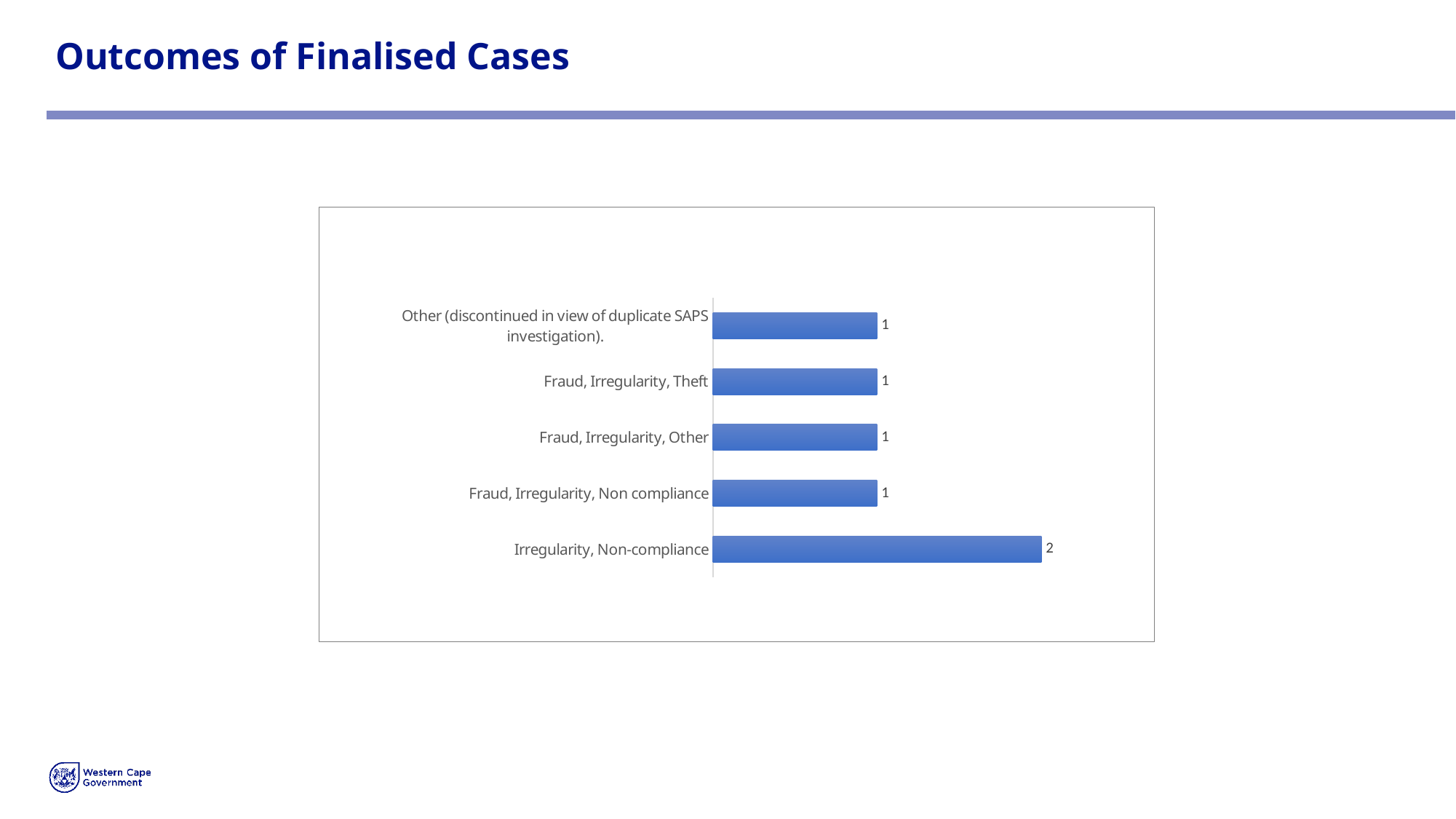
What is the value for Irregularity, Non-compliance? 2 What kind of chart is shown on the slide? Bar chart What is the value for Fraud, Irregularity, Non compliance? 1 Which category has the highest value? Irregularity, Non-compliance How many categories are shown in the chart? 5 What is the title of the slide? Outcomes of Finalised Cases What colour are the bars in the chart? Blue Which is larger: the value for Irregularity, Non-compliance or the value for Fraud, Irregularity, Theft? Irregularity, Non-compliance What is the total of all the values shown in the chart? 6 What is the value for Fraud, Irregularity, Theft? 1 What is the value for Other (discontinued in view of duplicate SAPS investigation).? 1 What is the difference between the values for Irregularity, Non-compliance and Fraud, Irregularity, Other? 1